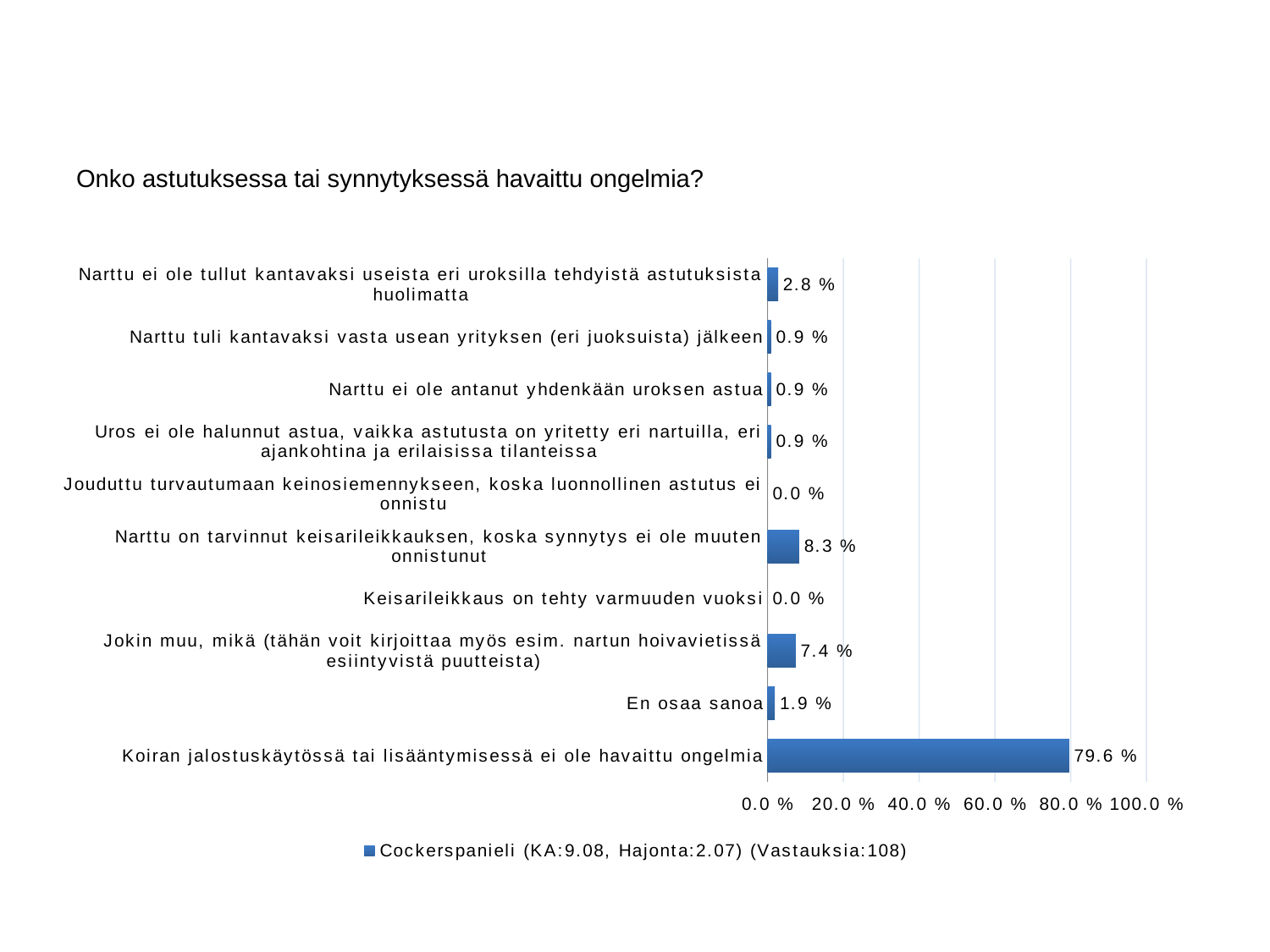
What kind of chart is shown on the slide? bar chart How many categories are shown in the chart? 10 Is the value for "Koiran jalostuskäytössä tai lisääntymisessä ei ole havaittu ongelmia" greater or less than 60.0 %? greater Which category has the highest value? Koiran jalostuskäytössä tai lisääntymisessä ei ole havaittu ongelmia What is the value for "Keisarileikkaus on tehty varmuuden vuoksi"? 0.0 % What is the title of the chart? Onko astutuksessa tai synnytyksessä havaittu ongelmia? Which is larger: the value for "Narttu ei ole tullut kantavaksi useista eri uroksilla tehdyistä astutuksista huolimatta" or the value for "En osaa sanoa"? Narttu ei ole tullut kantavaksi useista eri uroksilla tehdyistä astutuksista huolimatta How many series does the legend list? 1 What is the difference between the values for "Narttu on tarvinnut keisarileikkauksen, koska synnytys ei ole muuten onnistunut" and "Jokin muu, mikä"? 0.9 % What is the value for "Narttu on tarvinnut keisarileikkauksen, koska synnytys ei ole muuten onnistunut"? 8.3 % What is the value for "Koiran jalostuskäytössä tai lisääntymisessä ei ole havaittu ongelmia"? 79.6 % What is the value for "En osaa sanoa"? 1.9 %